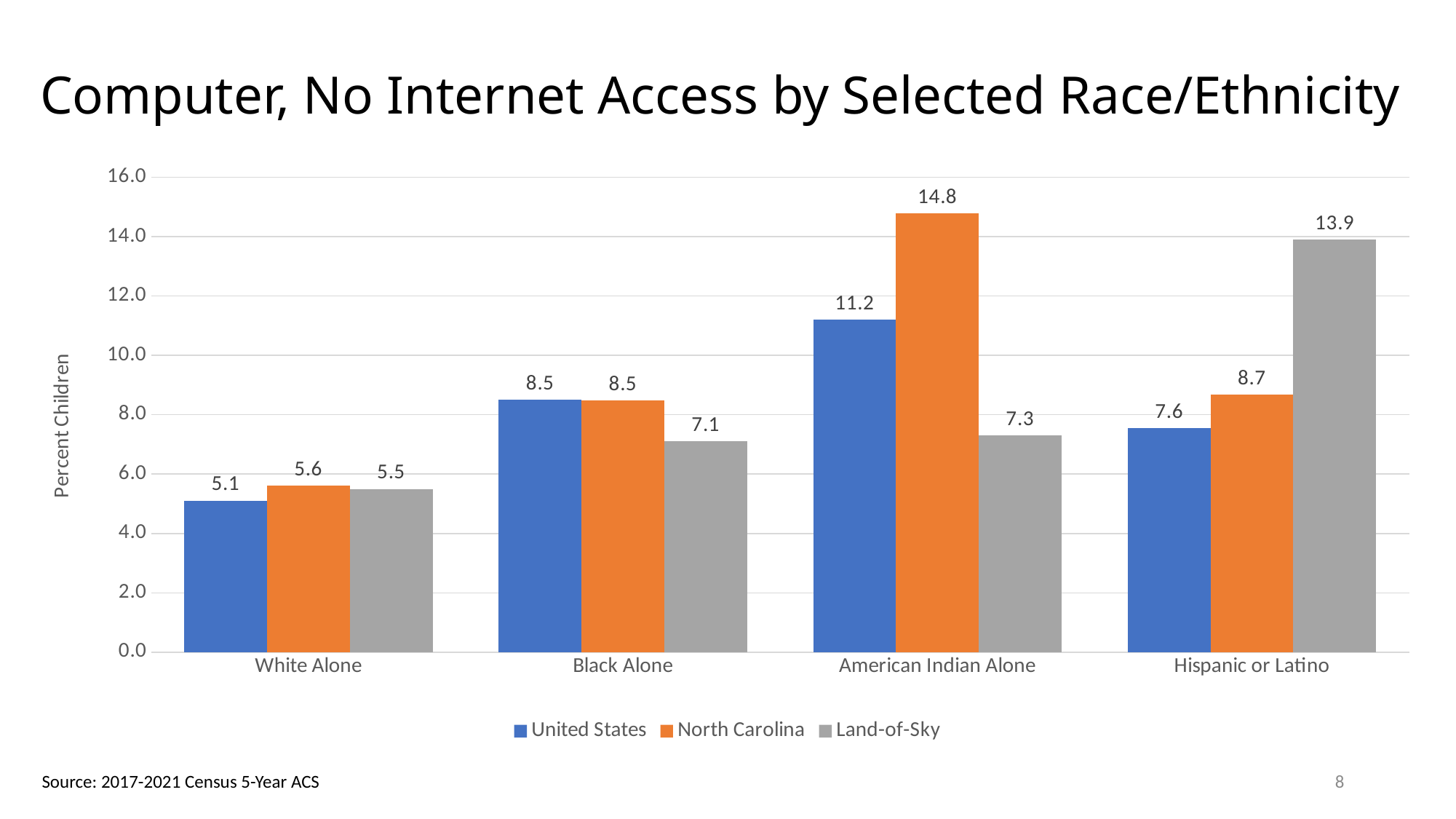
What is the title of the chart? Computer, No Internet Access by Selected Race/Ethnicity What kind of chart is shown on the slide? Bar chart Which is larger in the Hispanic or Latino category: the United States value or the Land-of-Sky value? Land-of-Sky Which category has the highest value for the United States series? American Indian Alone What is the value for United States in the White Alone category? 5.1 What is the label of the y axis? Percent Children What is the difference between the North Carolina and Land-of-Sky values in the American Indian Alone category? 7.5 What is the value for Land-of-Sky in the Hispanic or Latino category? 13.9 What is the value for North Carolina in the American Indian Alone category? 14.8 How many race/ethnicity categories are shown on the x axis? 4 Which category has the lowest value for the Land-of-Sky series? White Alone How many series does the legend list? 3